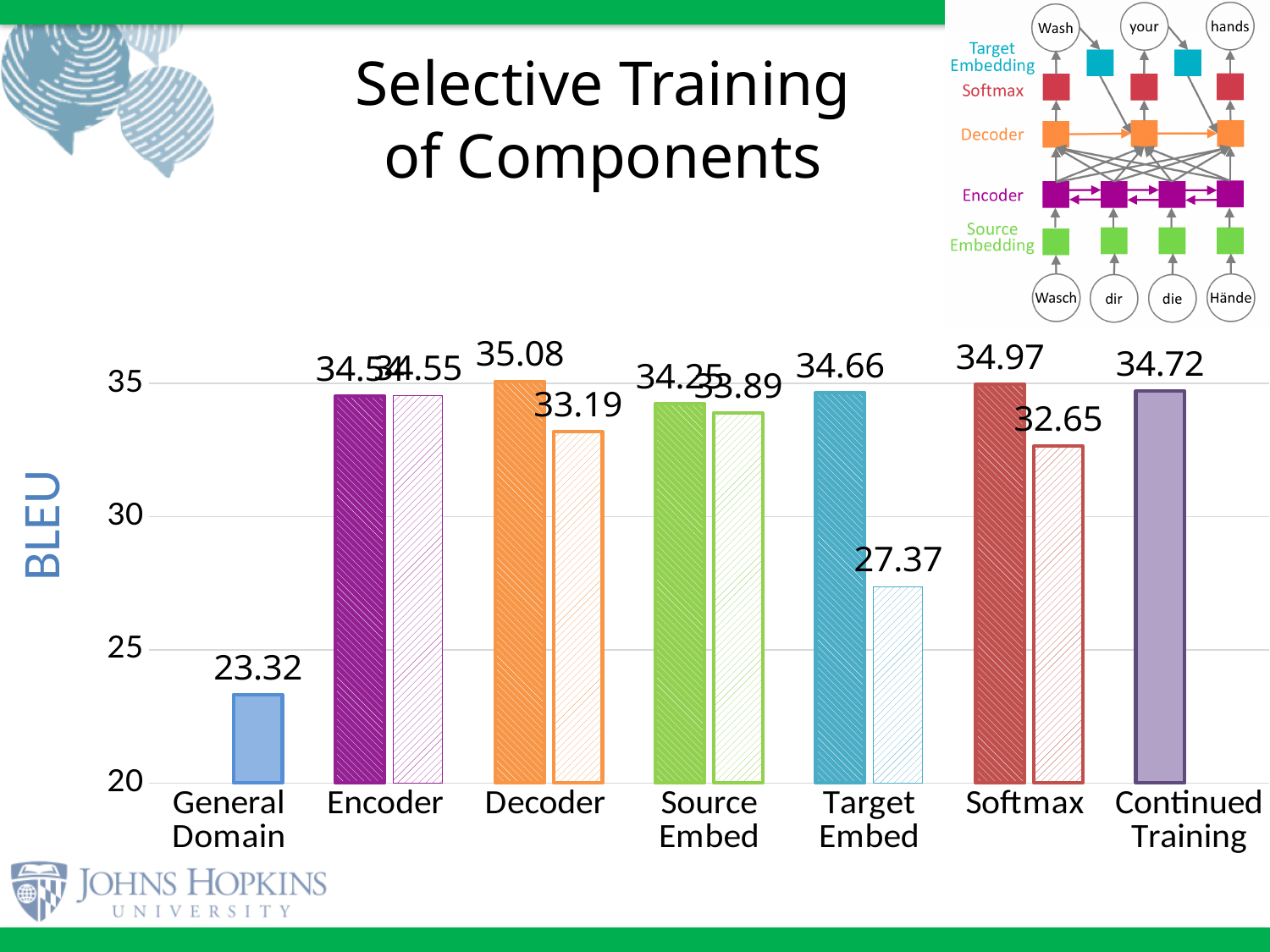
What is the BLEU value for General Domain? 23.32 What is the value of the hatched (second) bar for Decoder? 33.19 What is the BLEU value for Continued Training? 34.72 What is the value of the solid (first) bar for Decoder? 35.08 What is the value of the hatched (second) bar for Softmax? 32.65 Which category has the lowest BLEU value? General Domain What is the label on the y axis? BLEU What is the difference between the two bars for Target Embed (34.66 and 27.37)? 7.29 Is the value for General Domain greater or less than 25? less How many categories are shown on the x axis? 7 What is the value of the hatched (second) bar for Target Embed? 27.37 What kind of chart is shown on the slide? bar chart